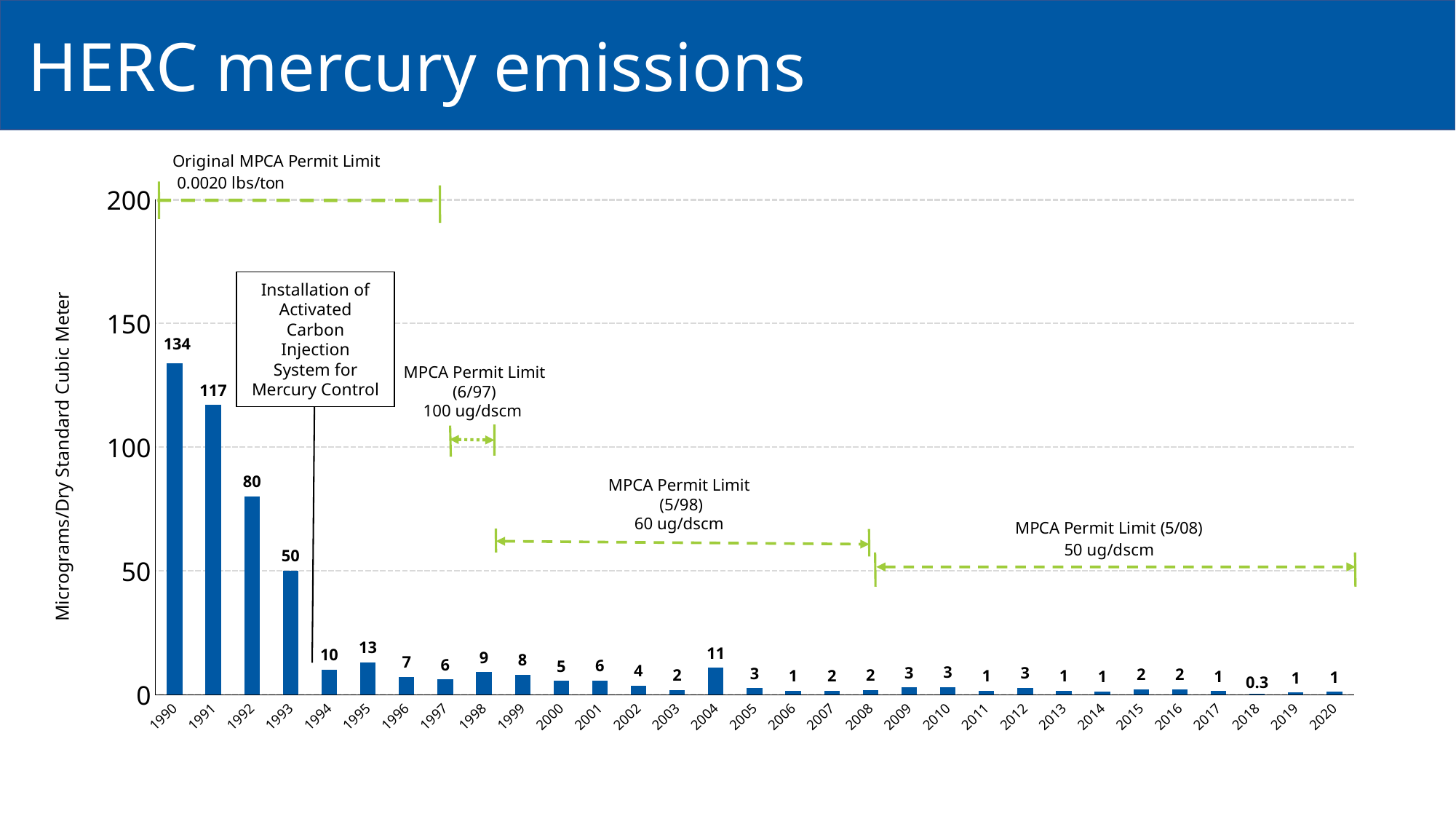
What is the value shown for 1993? 50 What is the label of the y axis? Micrograms/Dry Standard Cubic Meter Which year has the lowest mercury emissions value? 2018 What is the difference between the values for 1990 and 1991? 17 What is the mercury emissions value for 1990? 134 Is the value for 1992 greater or less than 100? less How many years are plotted on the x axis? 31 Which year has the larger value, 1995 or 1996? 1995 Which year has the highest mercury emissions value? 1990 What is the value shown for 2004? 11 What kind of chart is shown on the slide? Bar chart What is the value shown for 2018? 0.3